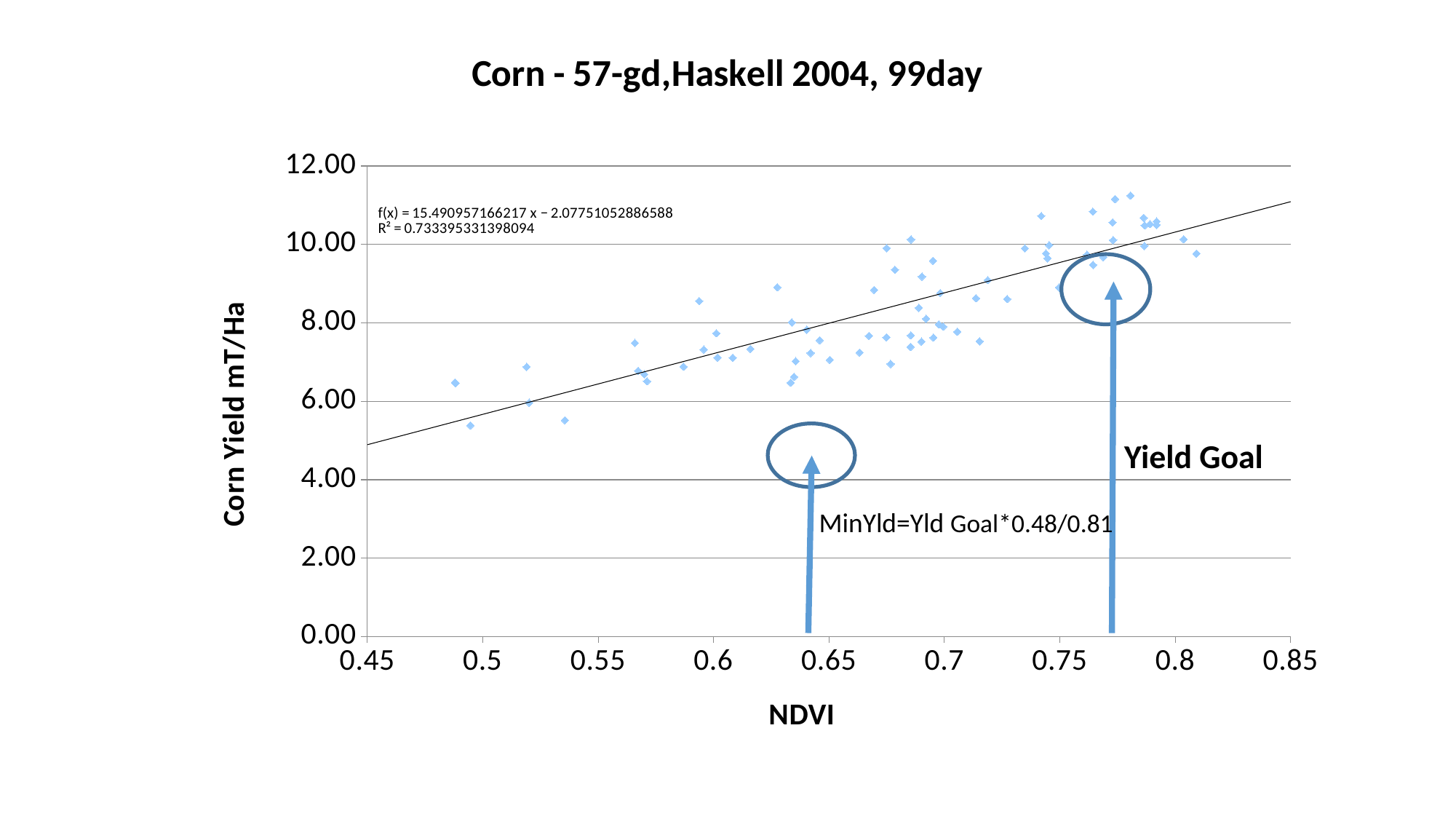
Do the plotted corn yield values generally rise or fall as NDVI increases? rise Is the lowest plotted corn yield greater or less than 6.00? less What is the maximum value shown on the y axis? 12.00 Is the lowest NDVI value plotted greater or less than 0.5? less Is the highest plotted corn yield greater or less than 10.00? greater What is the slope of the trendline equation printed on the chart? 15.490957166217 What kind of chart is shown on the slide? scatter chart What is the title of the chart? Corn - 57-gd,Haskell 2004, 99day What is the intercept of the trendline equation printed on the chart? −2.07751052886588 What is the label of the x axis? NDVI What R² value is printed on the chart for the trendline? 0.733395331398094